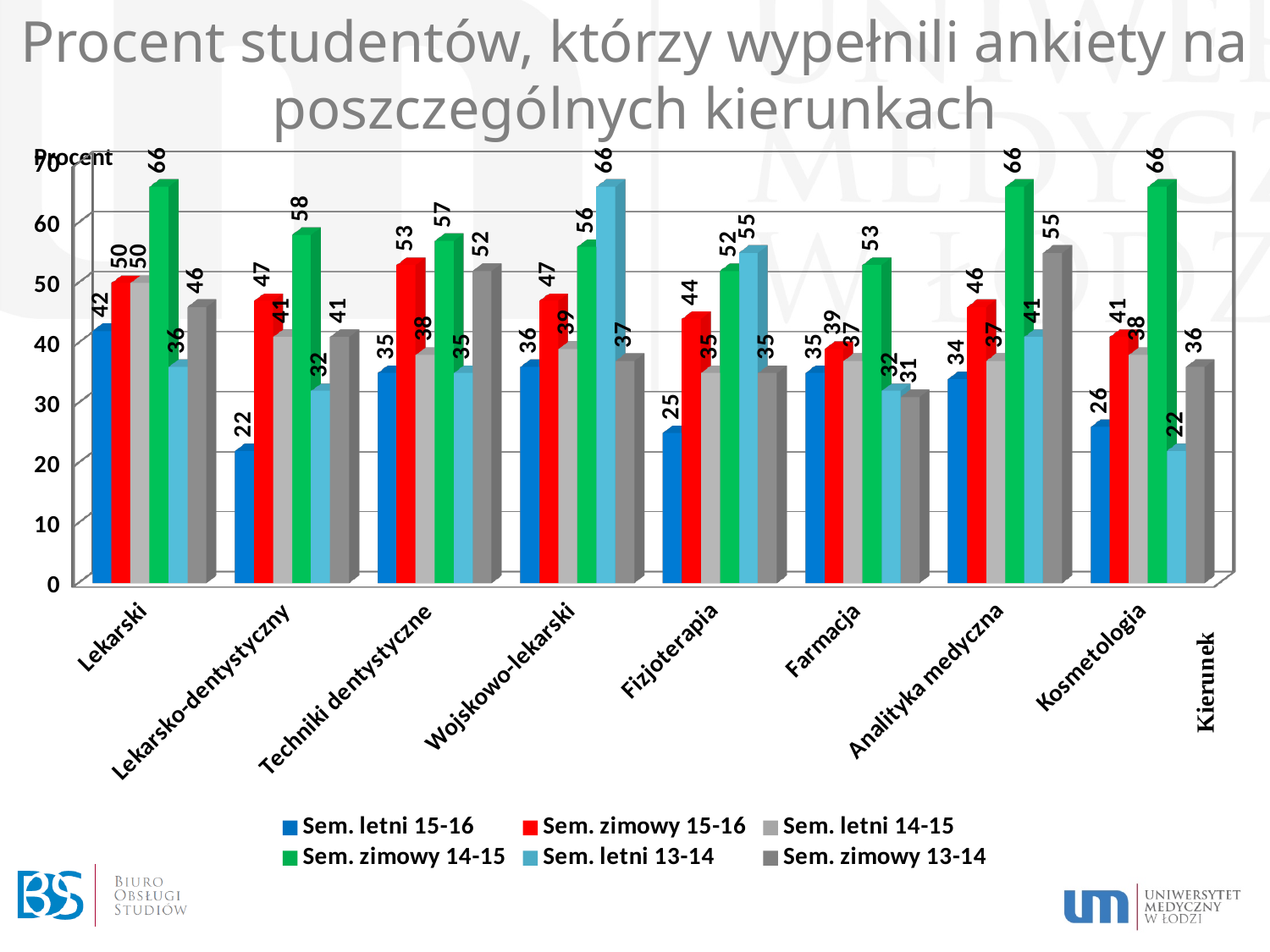
Which kierunek has the highest value in Sem. zimowy 15-16? Techniki dentystyczne How many kierunki (categories) are shown on the x axis? 8 What is the value for Wojskowo-lekarski in Sem. letni 13-14? 66 What is the value for Lekarski in Sem. zimowy 14-15? 66 How many series does the legend list? 6 What is the value for Fizjoterapia in Sem. letni 15-16? 25 Which is larger for Farmacja: the Sem. zimowy 15-16 value or the Sem. zimowy 14-15 value? Sem. zimowy 14-15 What is the label of the vertical axis? Procent Which kierunek has the lowest value in Sem. letni 13-14? Kosmetologia Which kierunek has the lowest value in Sem. letni 15-16? Lekarsko-dentystyczny What is the difference between the Sem. zimowy 14-15 and Sem. letni 15-16 values for Kosmetologia? 40 What type of chart is shown on the slide? bar chart